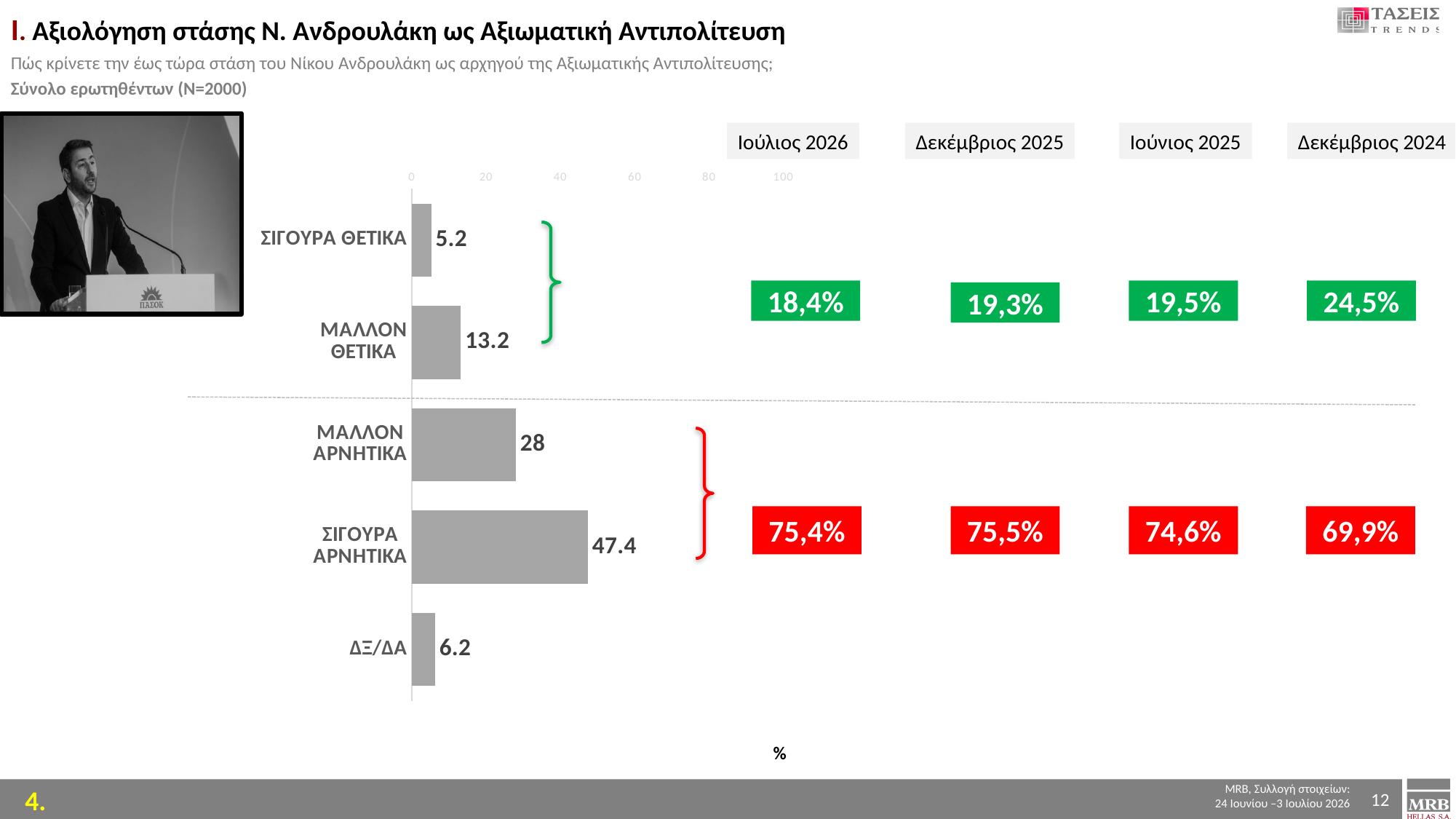
Which category has the highest value in the bar chart? ΣΙΓΟΥΡΑ ΑΡΝΗΤΙΚΑ Is the value for ΜΑΛΛΟΝ ΑΡΝΗΤΙΚΑ greater or less than 20? greater Which is larger, the value for ΜΑΛΛΟΝ ΘΕΤΙΚΑ or the value for ΔΞ/ΔΑ? ΜΑΛΛΟΝ ΘΕΤΙΚΑ What kind of chart is shown on the slide? bar chart What is the combined positive (green) percentage shown for Ιούλιος 2026? 18,4% What is the difference between the values for ΣΙΓΟΥΡΑ ΑΡΝΗΤΙΚΑ and ΜΑΛΛΟΝ ΑΡΝΗΤΙΚΑ? 19.4 What is the value for ΜΑΛΛΟΝ ΘΕΤΙΚΑ in the bar chart? 13.2 Which category has the lowest value in the bar chart? ΣΙΓΟΥΡΑ ΘΕΤΙΚΑ What is the value for ΣΙΓΟΥΡΑ ΑΡΝΗΤΙΚΑ in the bar chart? 47.4 How many categories does the bar chart show? 5 What is the value for ΔΞ/ΔΑ in the bar chart? 6.2 What is the combined negative (red) percentage shown for Δεκέμβριος 2024? 69,9%